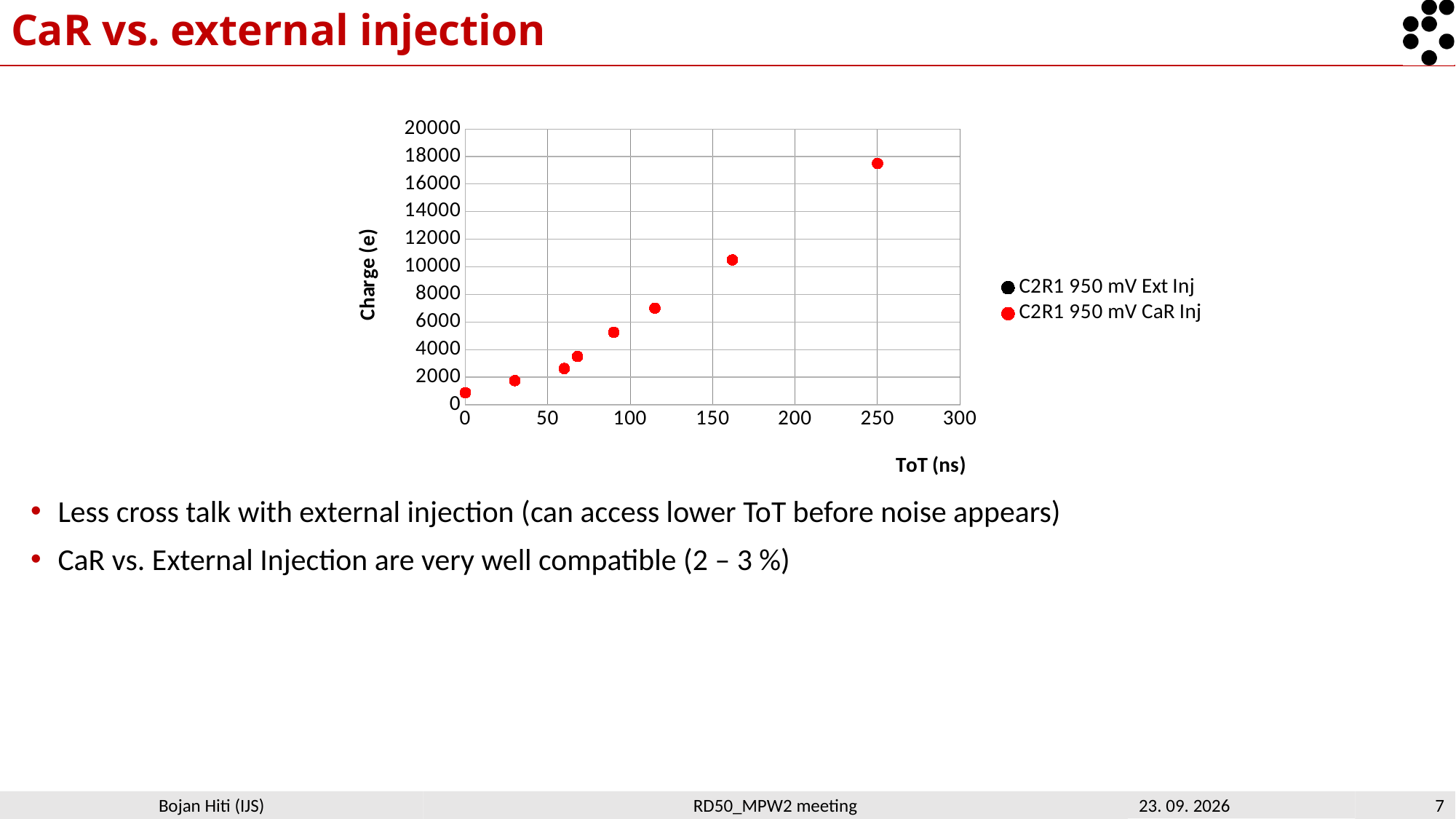
Which point has the higher charge: the one at about 250 ns ToT or the one at about 160 ns ToT? the one at about 250 ns ToT What is the highest value shown on the y axis? 20000 Is the charge of the point at about 90 ns ToT greater or less than 6000? less Is the charge of the point at about 115 ns ToT greater or less than 6000? greater Does the charge rise or fall as ToT increases along the x axis? rise What kind of chart is shown on the slide? scatter chart Is the charge of the point at about 250 ns ToT greater or less than 16000? greater What is the label of the y axis? Charge (e) What is the label of the x axis? ToT (ns) How many series does the legend list? 2